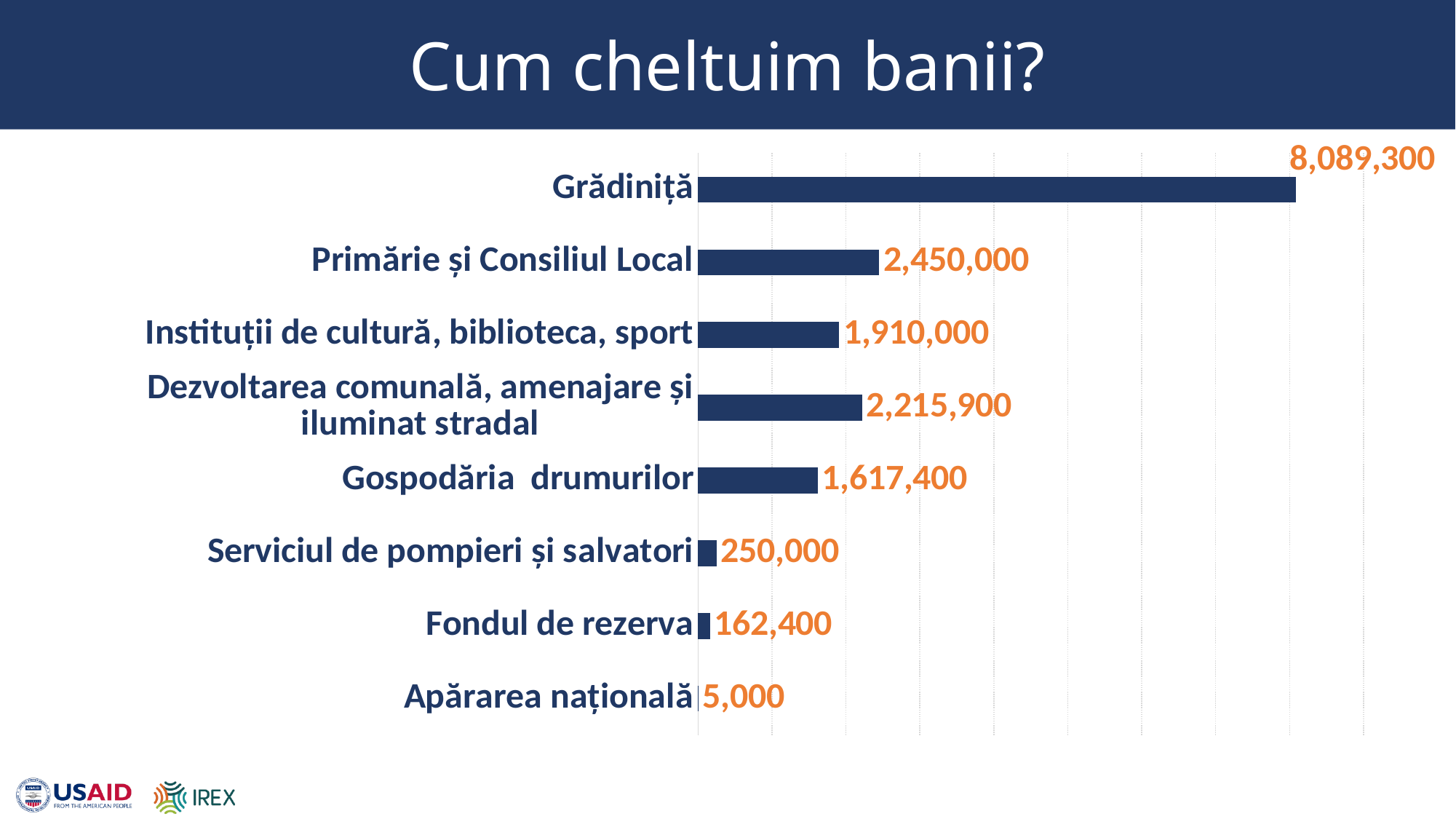
What kind of chart is shown on the slide? Bar chart What is the value for Grădiniță? 8,089,300 Which is larger: the value for Dezvoltarea comunală, amenajare și iluminat stradal or the value for Instituții de cultură, biblioteca, sport? Dezvoltarea comunală, amenajare și iluminat stradal Which category has the lowest value? Apărarea națională What is the value for Fondul de rezerva? 162,400 What is the value for Primărie și Consiliul Local? 2,450,000 How many categories are shown in the chart? 8 What is the difference between the values for Grădiniță and Primărie și Consiliul Local? 5,639,300 What is the title of the slide? Cum cheltuim banii? Which category has the highest value? Grădiniță What is the value for Gospodăria drumurilor? 1,617,400 What is the difference between the values for Serviciul de pompieri și salvatori and Fondul de rezerva? 87,600